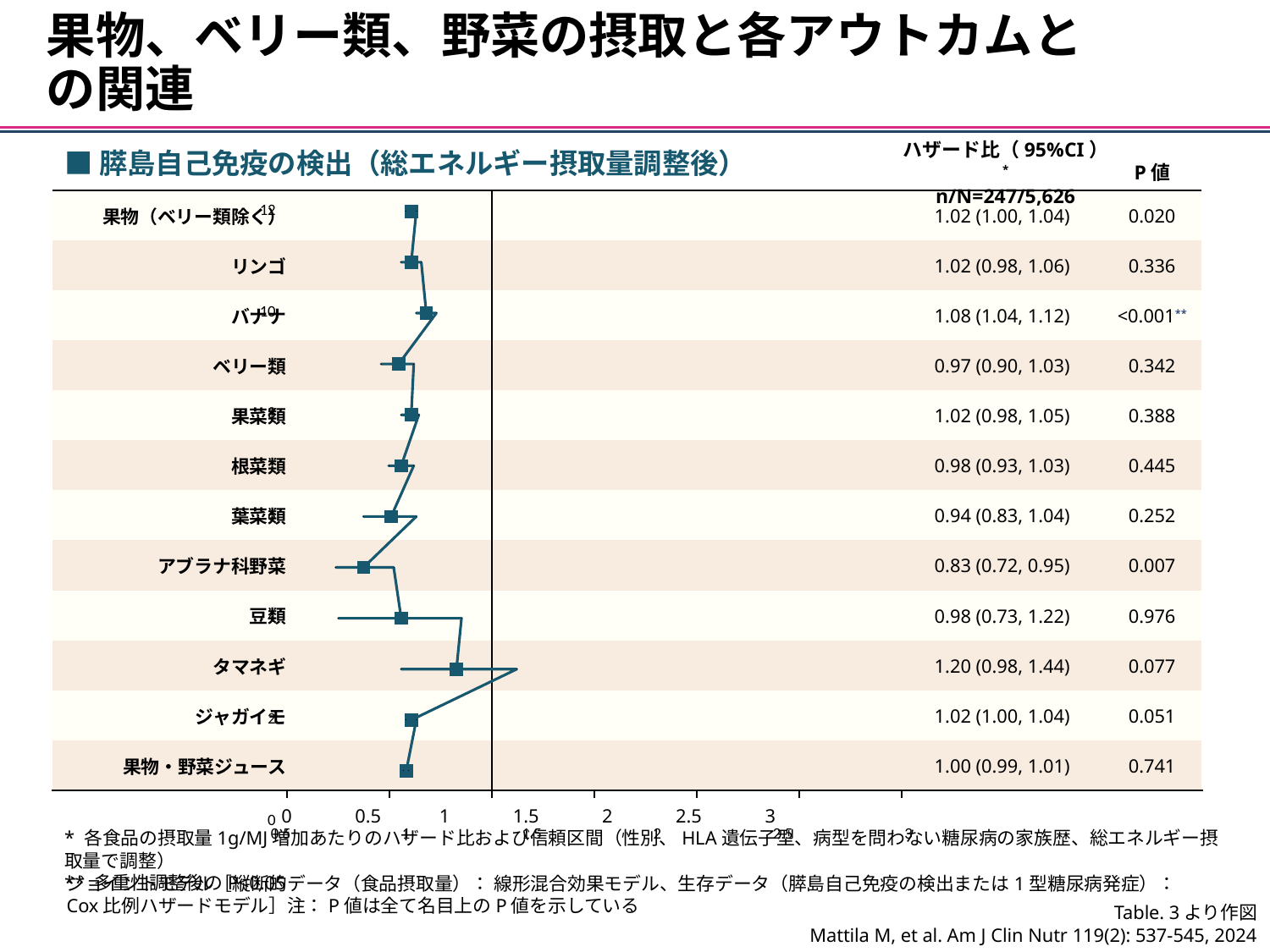
What is the difference between the hazard ratio for タマネギ and the hazard ratio for アブラナ科野菜? 0.37 Which food category has the lowest hazard ratio? アブラナ科野菜 Which has the larger hazard ratio, バナナ or ベリー類? バナナ What is the hazard ratio (95% CI) for アブラナ科野菜? 0.83 (0.72, 0.95) How many food categories are plotted in the chart? 12 What kind of chart is shown on the slide? forest plot Which food category has the highest hazard ratio? タマネギ What is the n/N value shown above the hazard ratio column? n/N=247/5,626 Is the hazard ratio for タマネギ greater or less than 1? greater What is the P value shown for タマネギ? 0.077 What is the hazard ratio (95% CI) for バナナ? 1.08 (1.04, 1.12) What is the hazard ratio (95% CI) for 果物・野菜ジュース? 1.00 (0.99, 1.01)